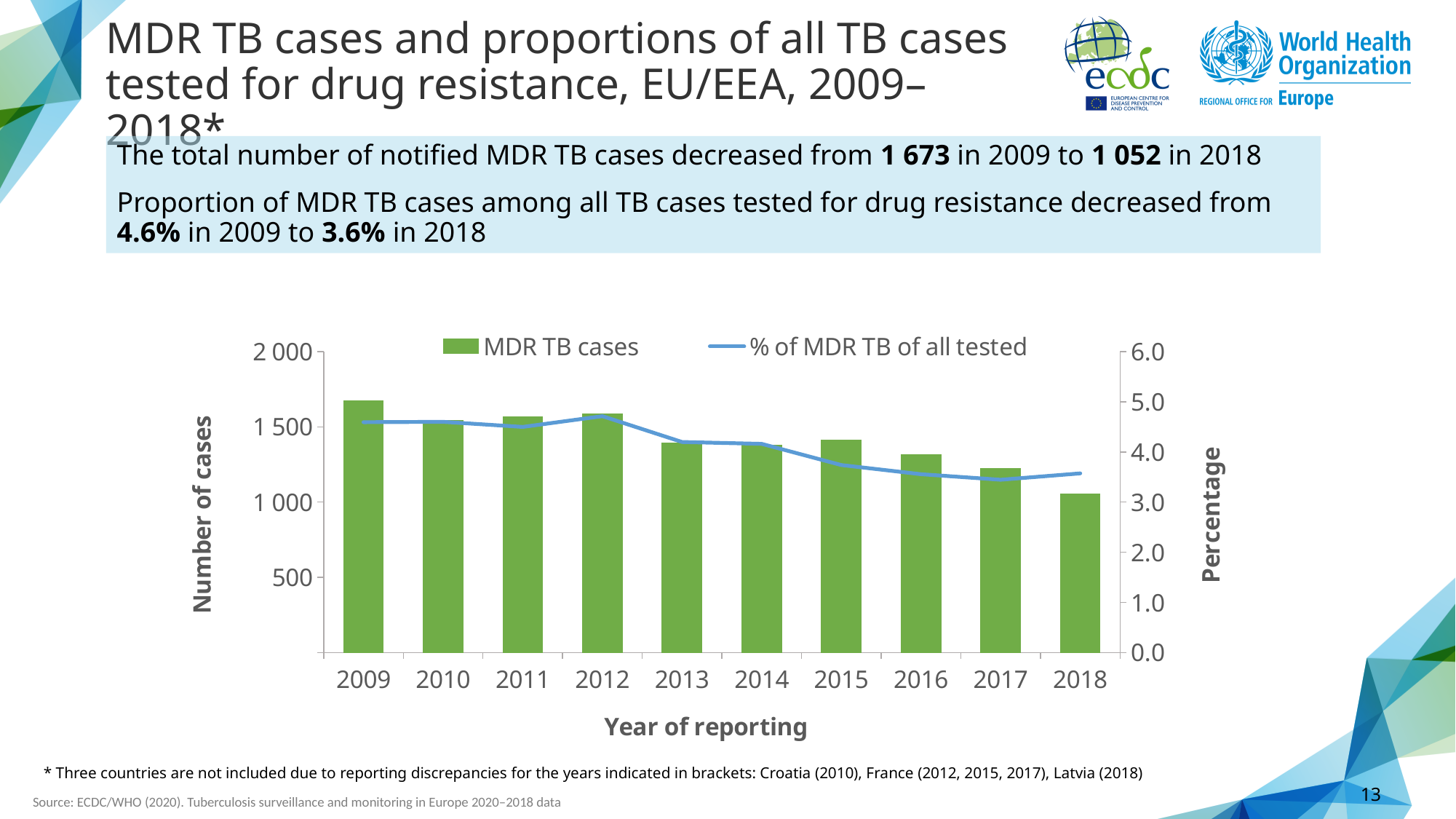
What is the overall trend of MDR TB cases from 2009 to 2018? Decreasing What type of chart is shown on the slide? Combined bar and line chart What was the proportion of MDR TB cases among all TB cases tested for drug resistance in 2018? 3.6% Which year has more MDR TB cases, 2011 or 2015? 2011 Is the % of MDR TB of all tested in 2017 greater or less than 4.0? less How many years of reporting are shown on the x axis? 10 Is the number of MDR TB cases in 2013 greater or less than 1 500? less How many series does the chart legend list? 2 Which year has the lowest number of MDR TB cases? 2018 By how much did the number of notified MDR TB cases decrease from 2009 to 2018? 621 Which year has the highest number of MDR TB cases? 2009 What was the number of notified MDR TB cases in 2009? 1 673